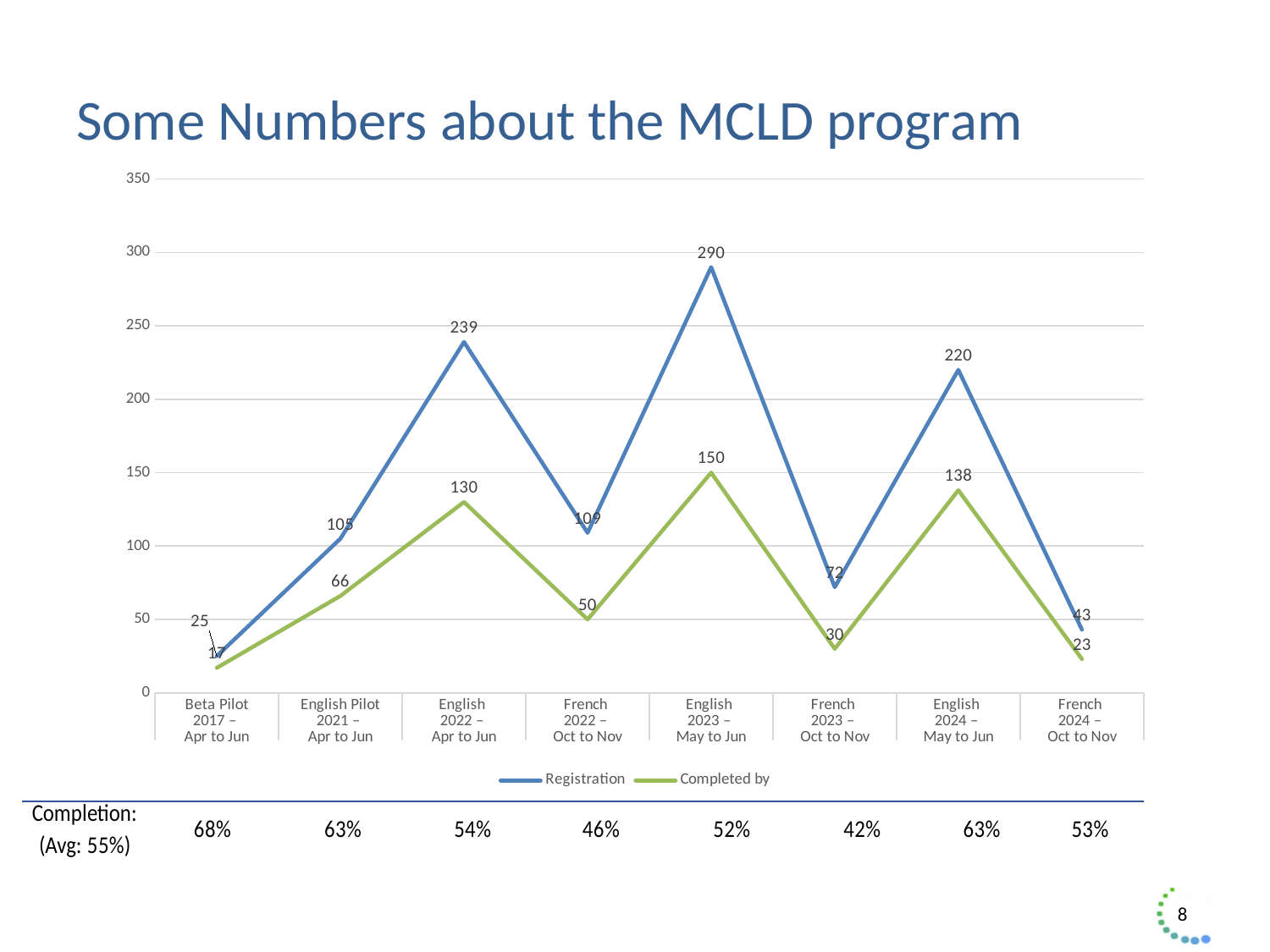
How many categories are shown on the x axis? 8 What is the Completed by value for English 2022 – Apr to Jun? 130 Which is larger, the Registration value for English 2022 – Apr to Jun or for English 2024 – May to Jun? English 2022 – Apr to Jun What is the Registration value for English 2023 – May to Jun? 290 What is the difference between Registration and Completed by for English 2024 – May to Jun? 82 What kind of chart is shown on the slide? Line chart What is the Registration value for French 2024 – Oct to Nov? 43 How many series does the legend list? 2 Which series is drawn in green? Completed by Which category has the lowest Completed by value? Beta Pilot 2017 – Apr to Jun Which category has the highest Registration value? English 2023 – May to Jun What is the completion percentage shown for French 2023 – Oct to Nov? 42%